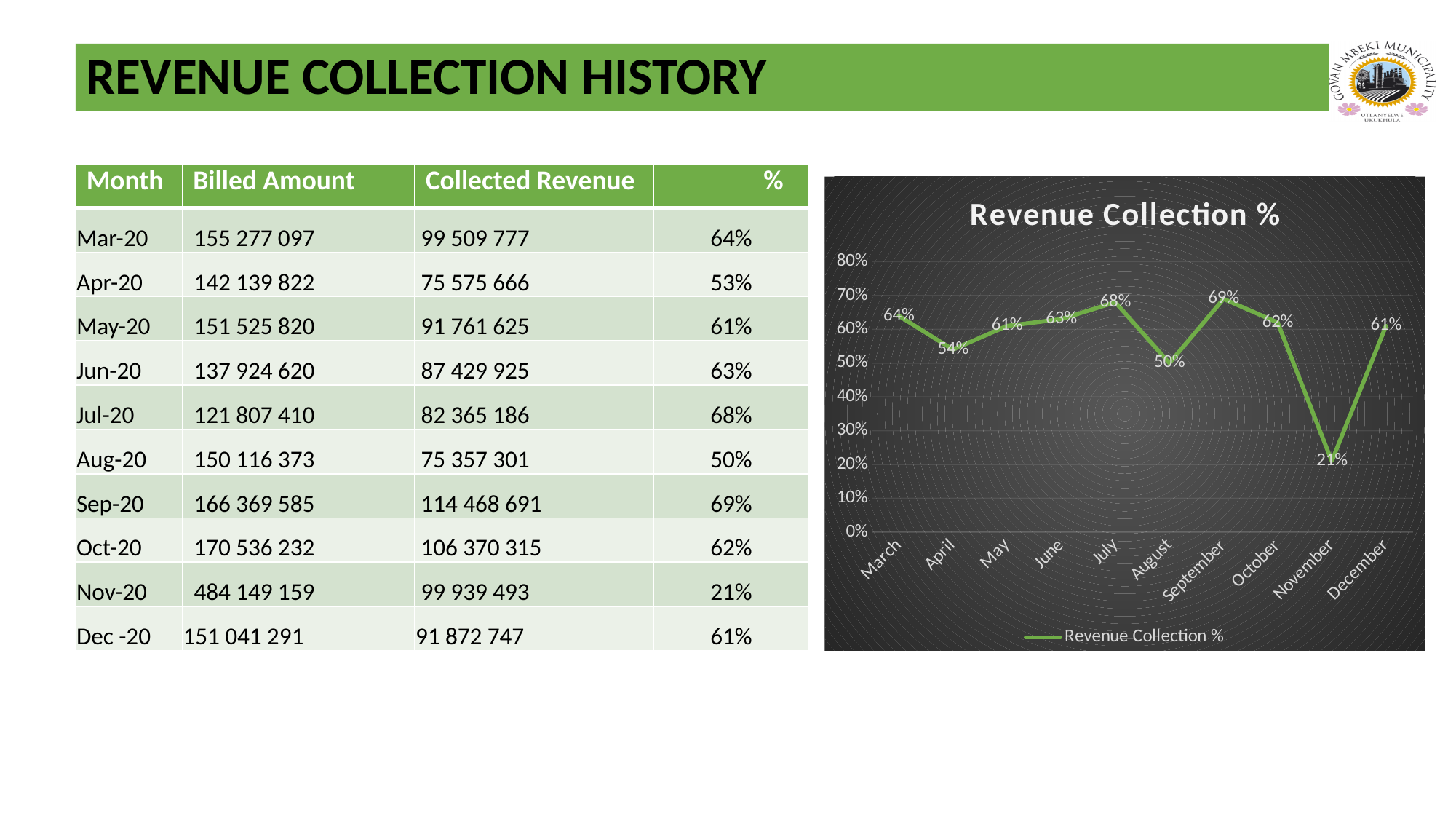
What is the Revenue Collection % for July? 68% How many months are plotted on the Revenue Collection % chart? 10 What is the difference between the Revenue Collection % for September and August? 19% Which month has a higher Revenue Collection %, March or June? March What is the Revenue Collection % for November? 21% Which month has the lowest Revenue Collection %? November Does the Revenue Collection % rise or fall from October to November? fall How many series does the legend of the Revenue Collection % chart list? 1 Which month has the highest Revenue Collection %? September What is the Revenue Collection % for April? 54% What kind of chart is the Revenue Collection % chart? line chart Is the Revenue Collection % for August greater or less than 60%? less